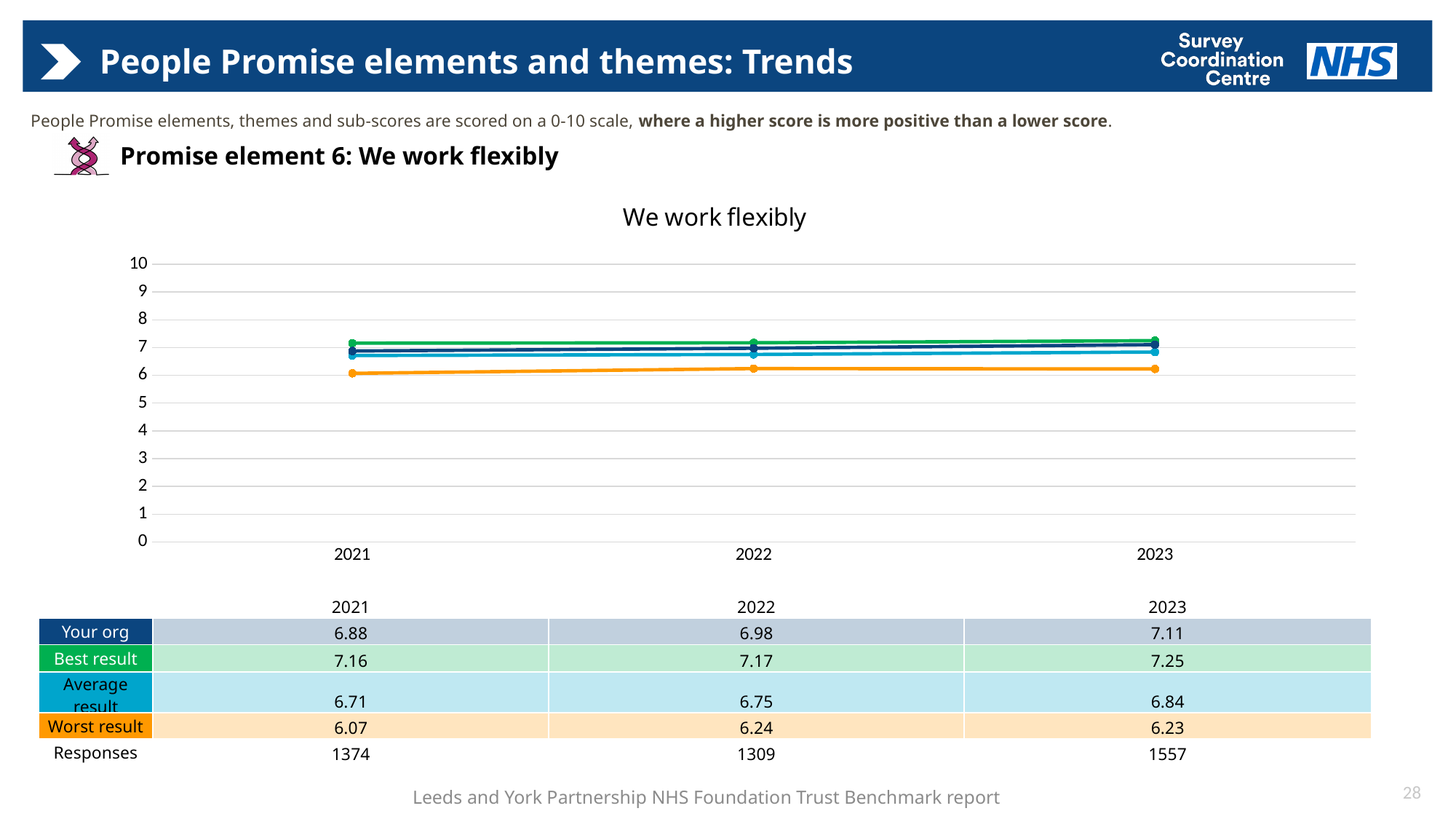
What is the Average result value in 2022 on the We work flexibly chart? 6.75 What is the value for Your org in 2023 on the We work flexibly chart? 7.11 Does the Your org line rise or fall from 2021 to 2023 on the We work flexibly chart? rise In which year is the Your org score lowest on the We work flexibly chart? 2021 What kind of chart is the We work flexibly chart? line chart Which is larger in 2022 on the We work flexibly chart: Your org or Average result? Your org What is the Worst result value in 2021 on the We work flexibly chart? 6.07 In which year is the Best result highest on the We work flexibly chart? 2023 How many series are plotted on the We work flexibly chart? 4 Is the Worst result value for 2022 greater or less than 7 on the We work flexibly chart? less How many years are plotted on the x axis of the We work flexibly chart? 3 What is the difference between the Best result and Your org in 2023 on the We work flexibly chart? 0.14